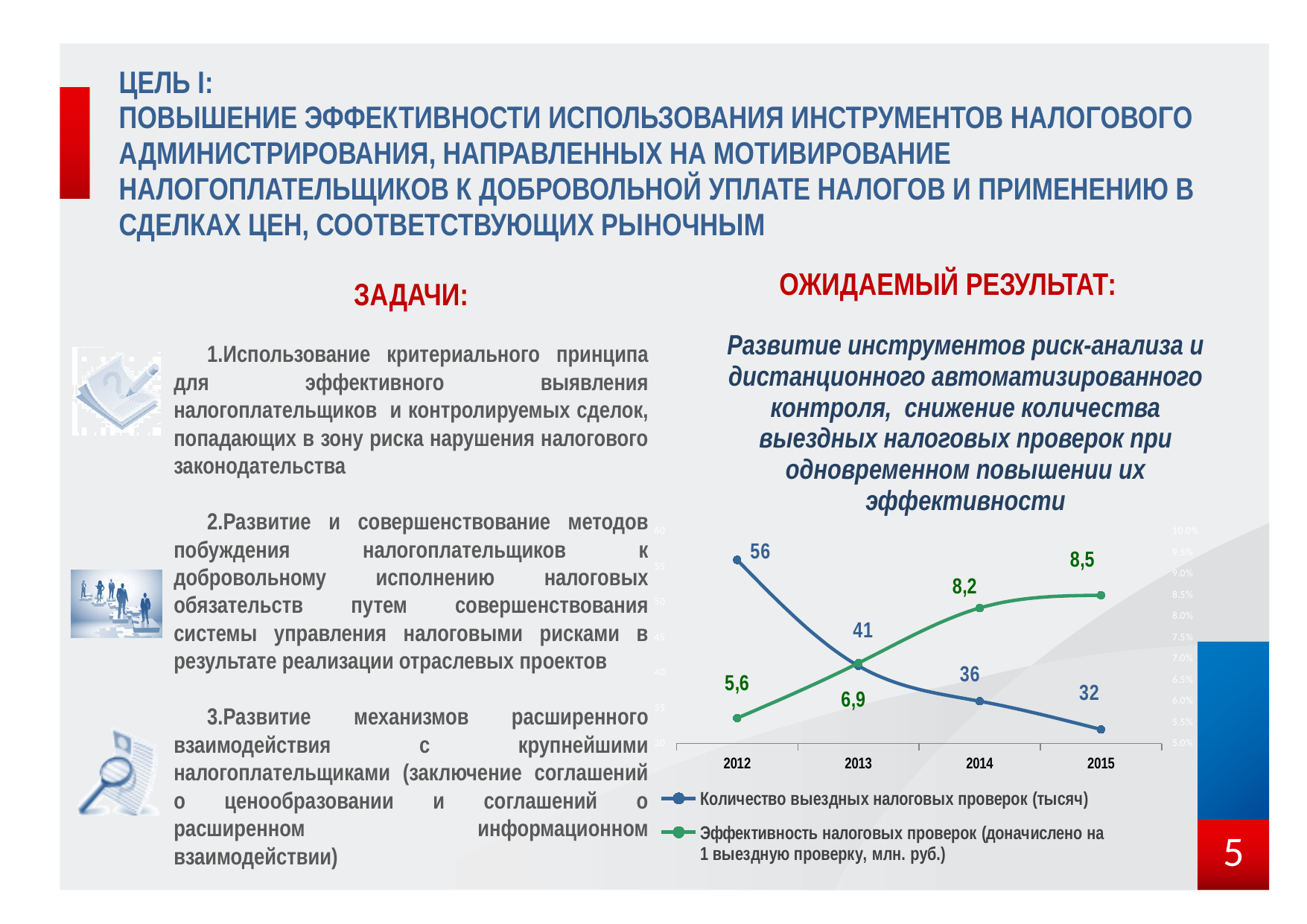
How many years are plotted on the x axis of the chart? 4 What is the difference between the 'Количество выездных налоговых проверок (тысяч)' values for 2012 and 2013? 15 In which year is 'Эффективность налоговых проверок' highest? 2015 What is the value of 'Эффективность налоговых проверок' in 2014? 8,2 Which year has a higher 'Эффективность налоговых проверок' value, 2012 or 2013? 2013 What is the value of 'Количество выездных налоговых проверок (тысяч)' in 2012? 56 Does 'Количество выездных налоговых проверок (тысяч)' rise or fall from 2012 to 2015? fall What is the value of 'Количество выездных налоговых проверок (тысяч)' in 2015? 32 How many series does the chart legend list? 2 In which year is 'Количество выездных налоговых проверок (тысяч)' lowest? 2015 What colour is the line for 'Эффективность налоговых проверок' in the chart? green What type of chart is shown on the slide? line chart